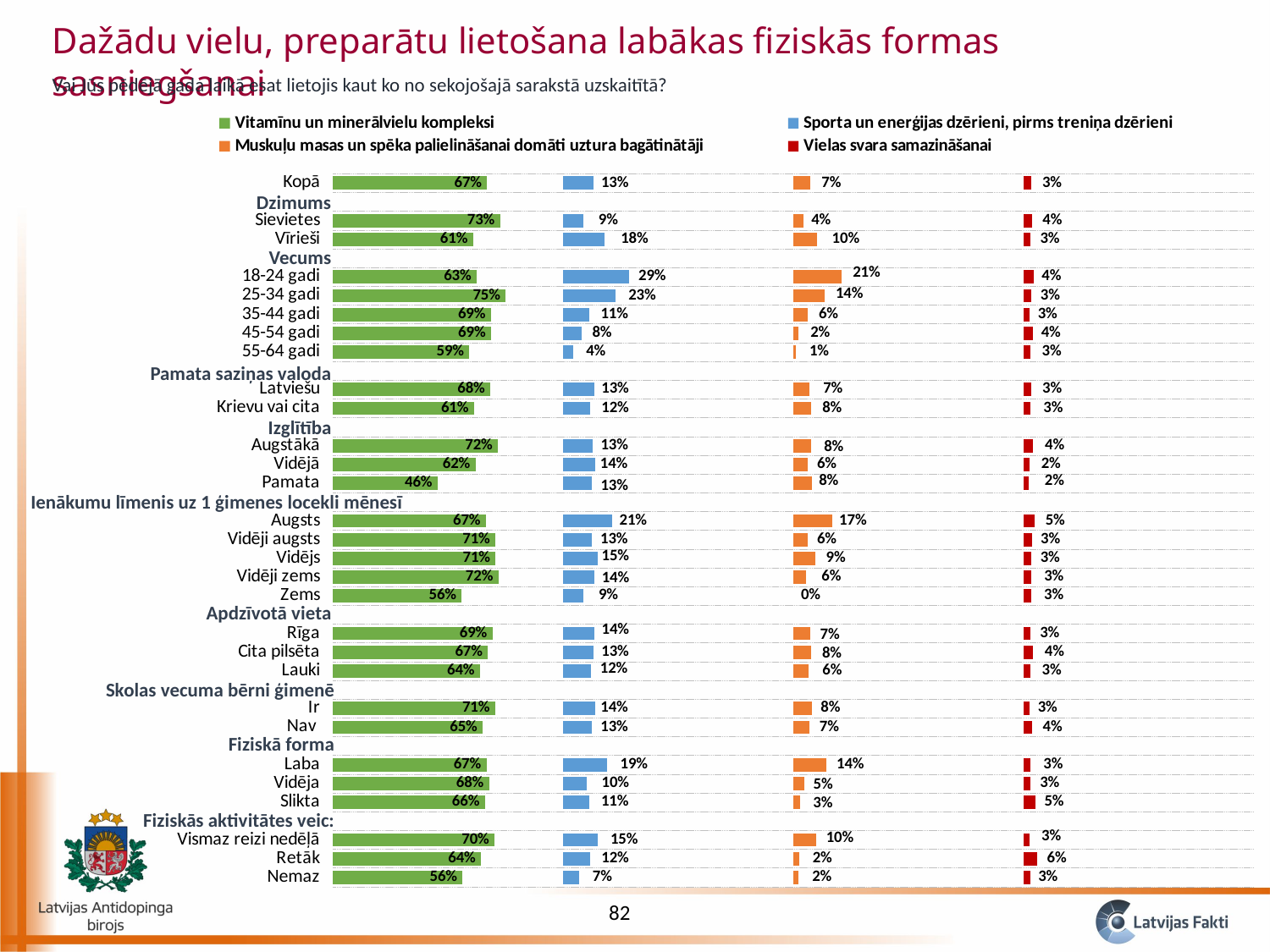
Which category has the highest value in the Sporta un enerģijas dzērieni, pirms treniņa dzērieni series? 18-24 gadi Which category has the highest value in the Vitamīnu un minerālvielu kompleksi series? 25-34 gadi What is the difference between Sievietes and Vīrieši in the Vitamīnu un minerālvielu kompleksi series? 12% What is the value for Vīrieši in the Sporta un enerģijas dzērieni, pirms treniņa dzērieni series? 18% What is the value for 18-24 gadi in the Muskuļu masas un spēka palielināšanai domāti uztura bagātinātāji series? 21% What kind of chart is shown on the slide? Bar chart Which category has the highest value in the Vielas svara samazināšanai series? Retāk Which is larger in the Sporta un enerģijas dzērieni, pirms treniņa dzērieni series: Augsts or Zems? Augsts Which category has the lowest value in the Vitamīnu un minerālvielu kompleksi series? Pamata How many series does the legend list? 4 What percentage of the Kopā group reported using Vitamīnu un minerālvielu kompleksi? 67% What colour represents the Vielas svara samazināšanai series? Red